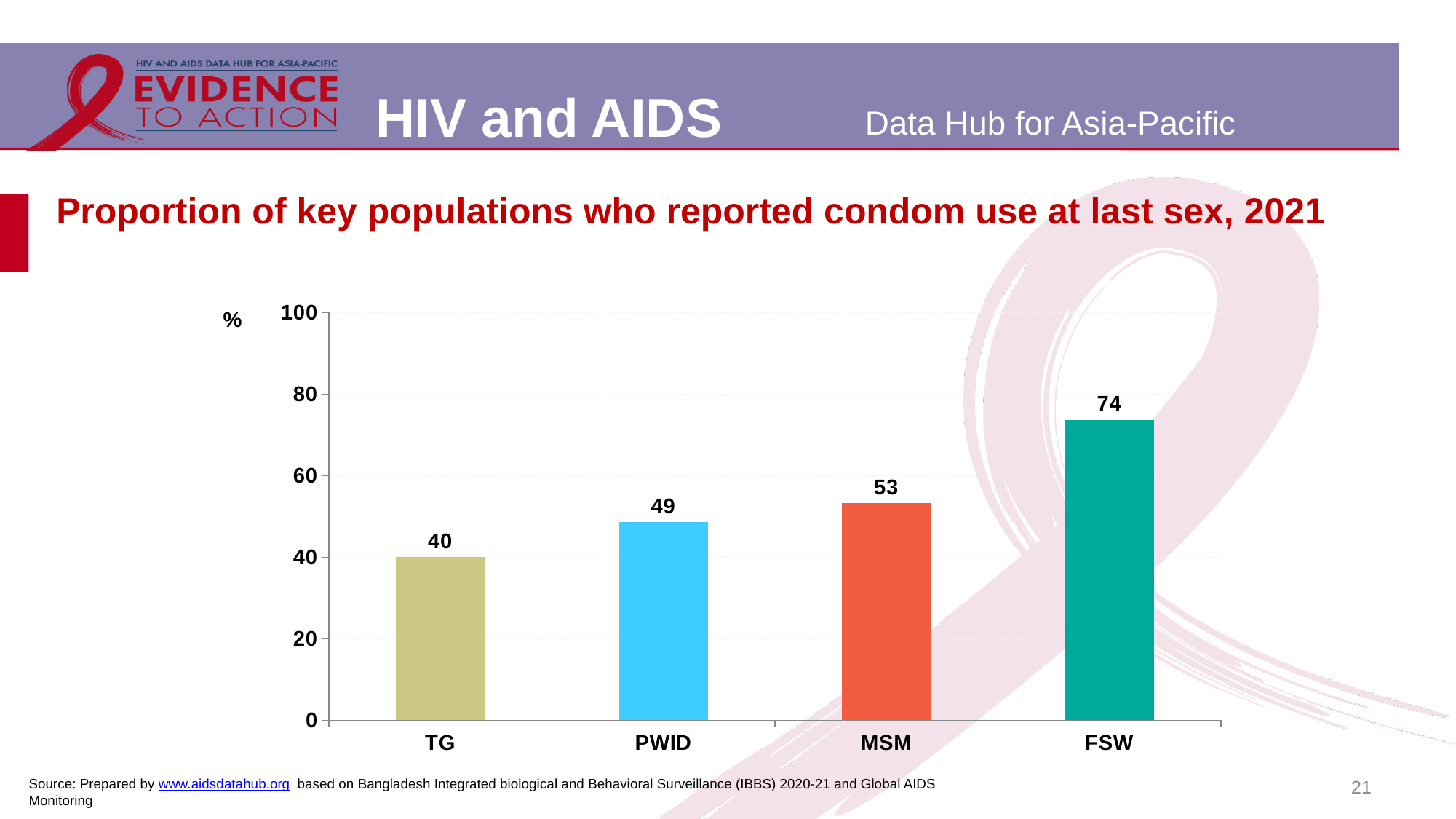
Which key population has the lowest proportion reporting condom use at last sex? TG What is the difference between the values for MSM and PWID? 4 Which is larger, the value for PWID or the value for MSM? MSM Is the value for FSW greater or less than 60? greater What is the value for TG? 40 How many key populations are shown in the chart? 4 What is the difference between the values for FSW and TG? 34 What kind of chart is shown on the slide? Bar chart What is the value for PWID? 49 Which key population has the highest proportion reporting condom use at last sex? FSW What is the value for MSM? 53 What is the value for FSW? 74